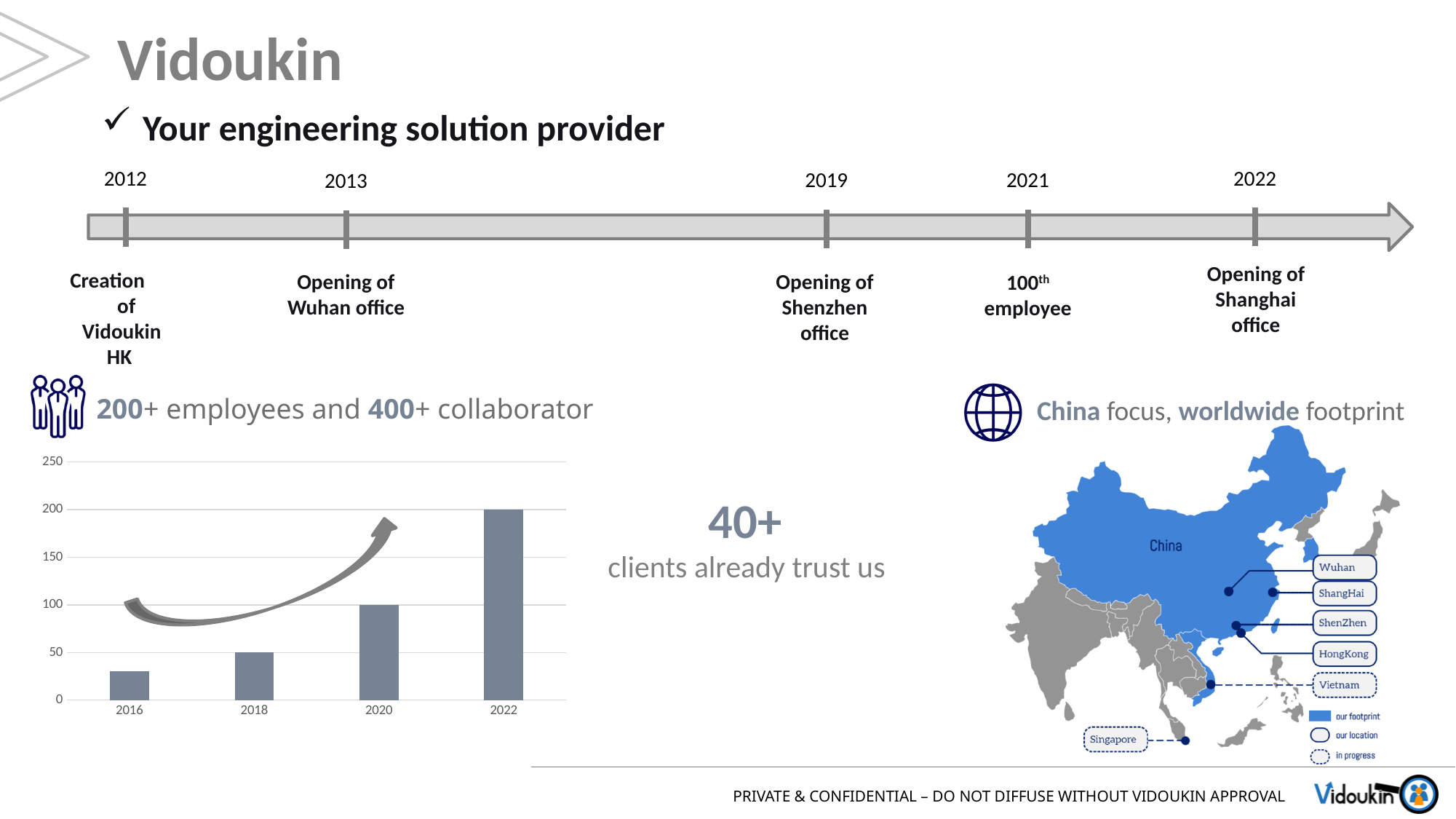
Which year has the lowest bar? 2016 What kind of chart is shown on the slide? bar chart Do the bar values rise or fall from 2016 to 2022? rise Is the value for 2016 greater or less than 50? less What is the value of the bar for 2022? 200 Which year has the highest bar? 2022 What is the value of the bar for 2020? 100 What is the difference between the values for 2020 and 2018? 50 What is the value of the bar for 2018? 50 How many years are shown on the x axis of the bar chart? 4 What is the difference between the values for 2022 and 2020? 100 Which is larger, the value for 2018 or the value for 2020? 2020